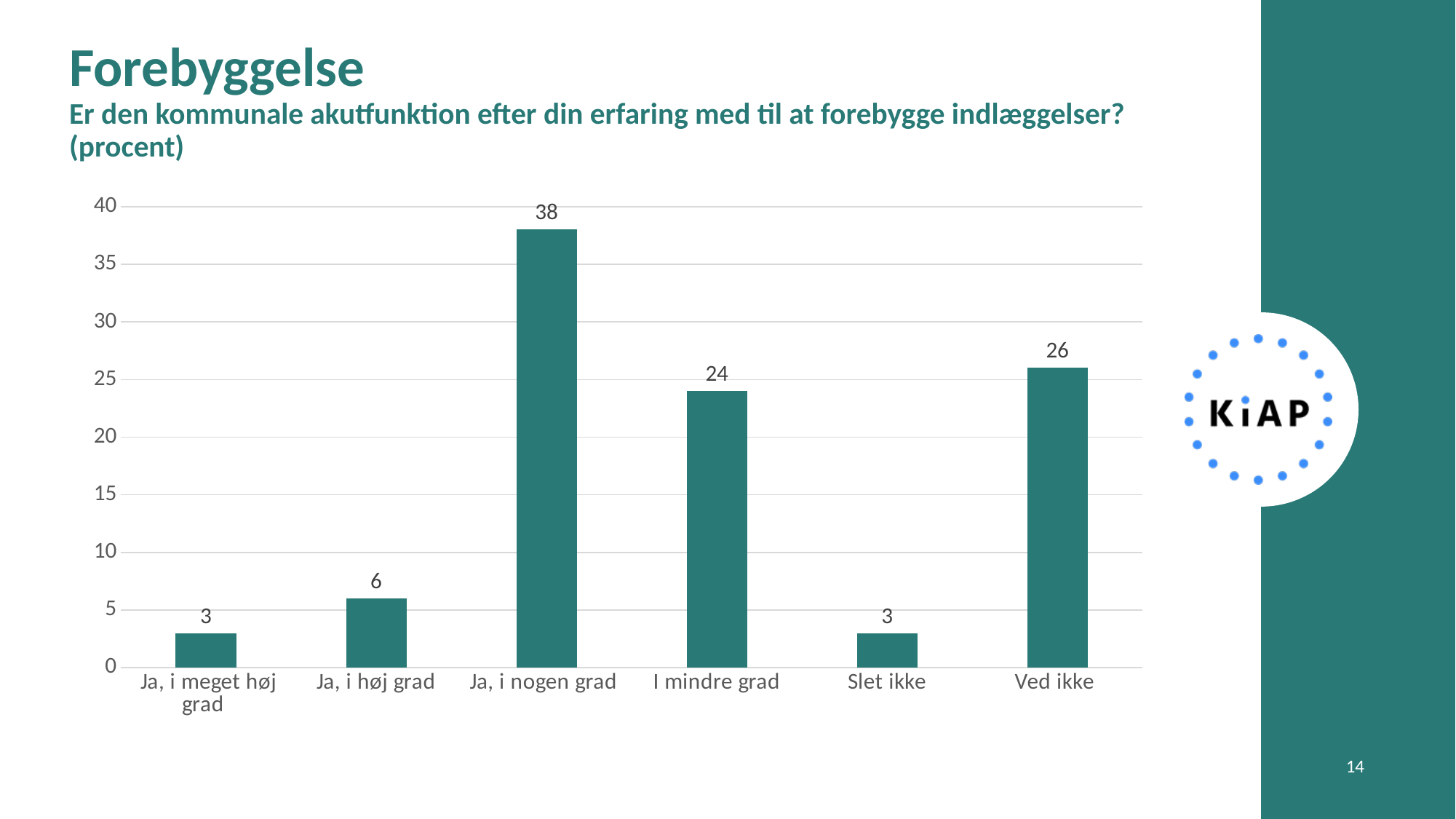
What is the value for "Ja, i høj grad"? 6 Which category has the highest value? Ja, i nogen grad What is the value for "Ved ikke"? 26 Which is larger, the value for "Ved ikke" or the value for "I mindre grad"? Ved ikke Is the value for "Ja, i nogen grad" greater or less than 35? greater What is the title of the slide? Forebyggelse What is the difference between the values for "Ja, i nogen grad" and "I mindre grad"? 14 What is the value for "I mindre grad"? 24 How many categories are shown on the x axis? 6 What kind of chart is shown on the slide? Bar chart What is the difference between the values for "Ved ikke" and "Ja, i høj grad"? 20 What is the value for "Ja, i nogen grad"? 38